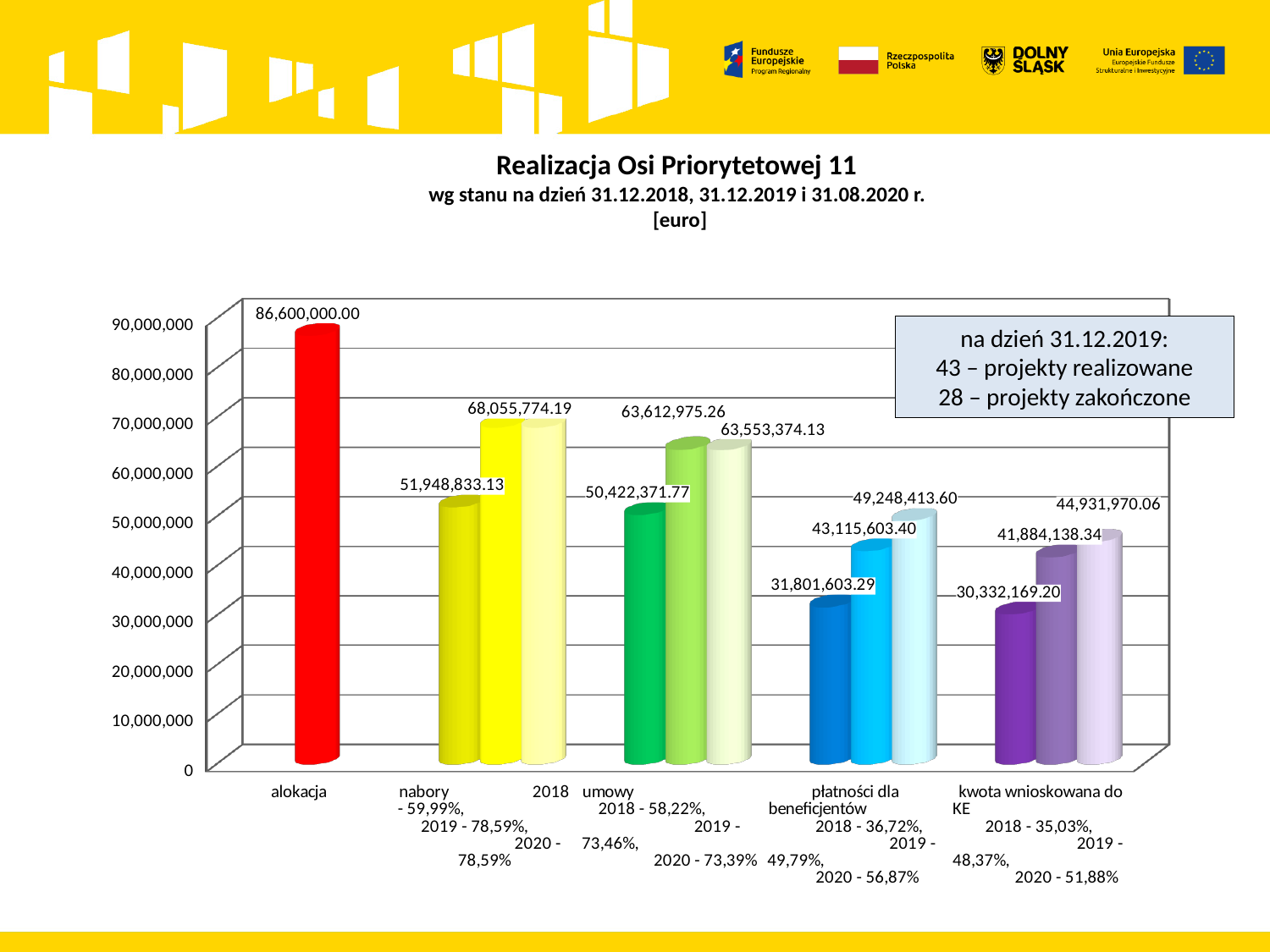
What is the 2020 value for płatności dla beneficjentów? 49,248,413.60 Which category has the highest bar on the chart? alokacja What is the 2018 value for nabory? 51,948,833.13 What is the value of the alokacja bar? 86,600,000.00 Which bar is the lowest on the chart? kwota wnioskowana do KE, 2018 (30,332,169.20) What is the 2019 value for umowy? 63,612,975.26 How many categories are shown on the x axis? 5 Is the 2019 value for kwota wnioskowana do KE greater or less than 40,000,000? greater Which is larger: the 2019 value for umowy or the 2020 value for umowy? 2019 (63,612,975.26) What type of chart is shown on the slide? bar chart What is the difference between the 2020 and 2018 values for płatności dla beneficjentów? 17,446,810.31 What is the 2018 value for kwota wnioskowana do KE? 30,332,169.20